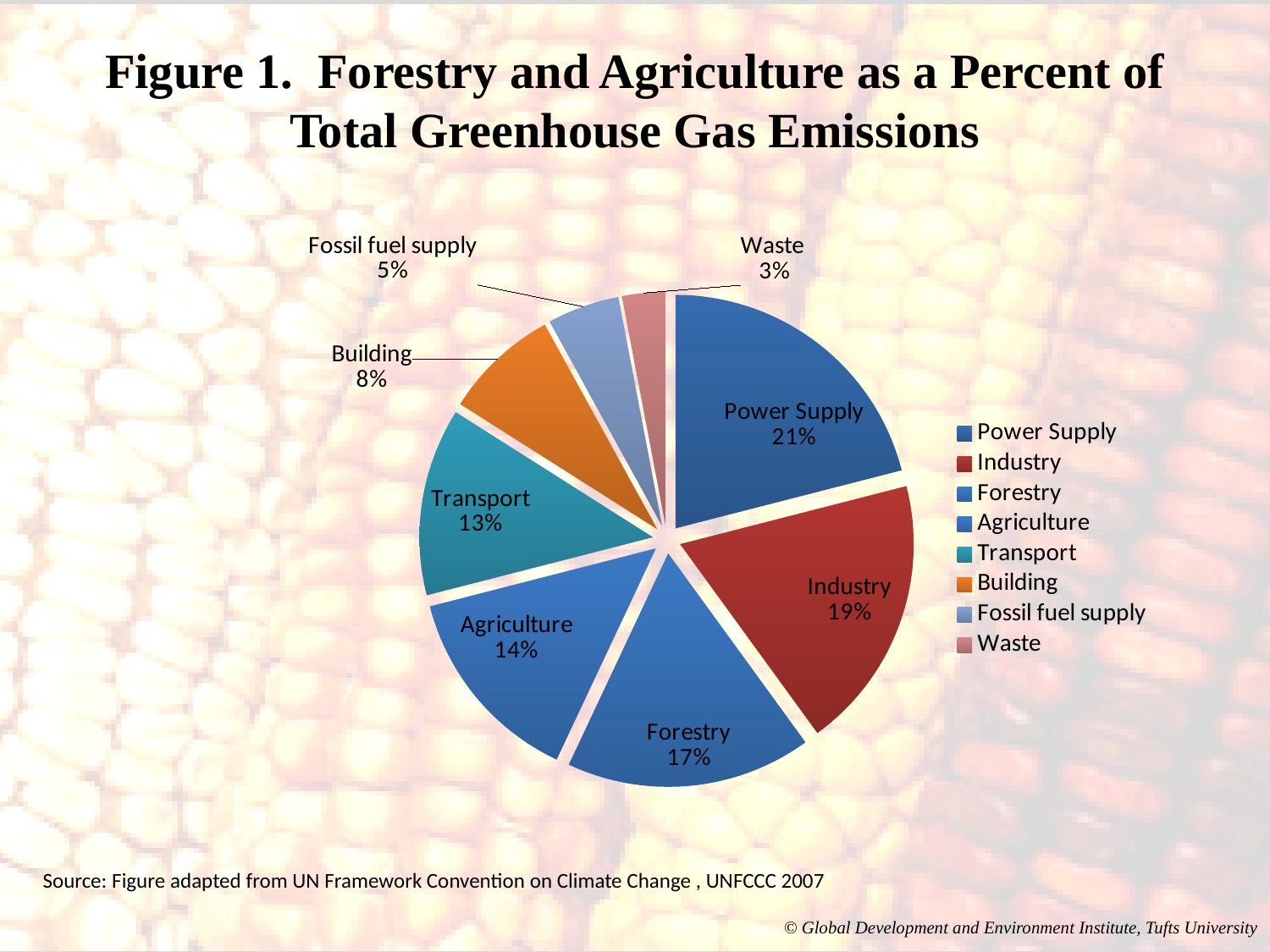
How many entries does the legend list? 8 Which category has the smallest share of the pie? Waste What is the value shown for Forestry? 17% Which category has the largest share of the pie? Power Supply What is the title of the figure? Figure 1. Forestry and Agriculture as a Percent of Total Greenhouse Gas Emissions What is the value shown for Fossil fuel supply? 5% What is the difference between the Industry and Building shares? 11% What percentage of total greenhouse gas emissions does Power Supply account for? 21% How many categories are shown in the pie chart? 8 What kind of chart is shown on the slide? pie chart What is the combined share of Forestry and Agriculture? 31% Which is larger, the share for Agriculture or the share for Transport? Agriculture